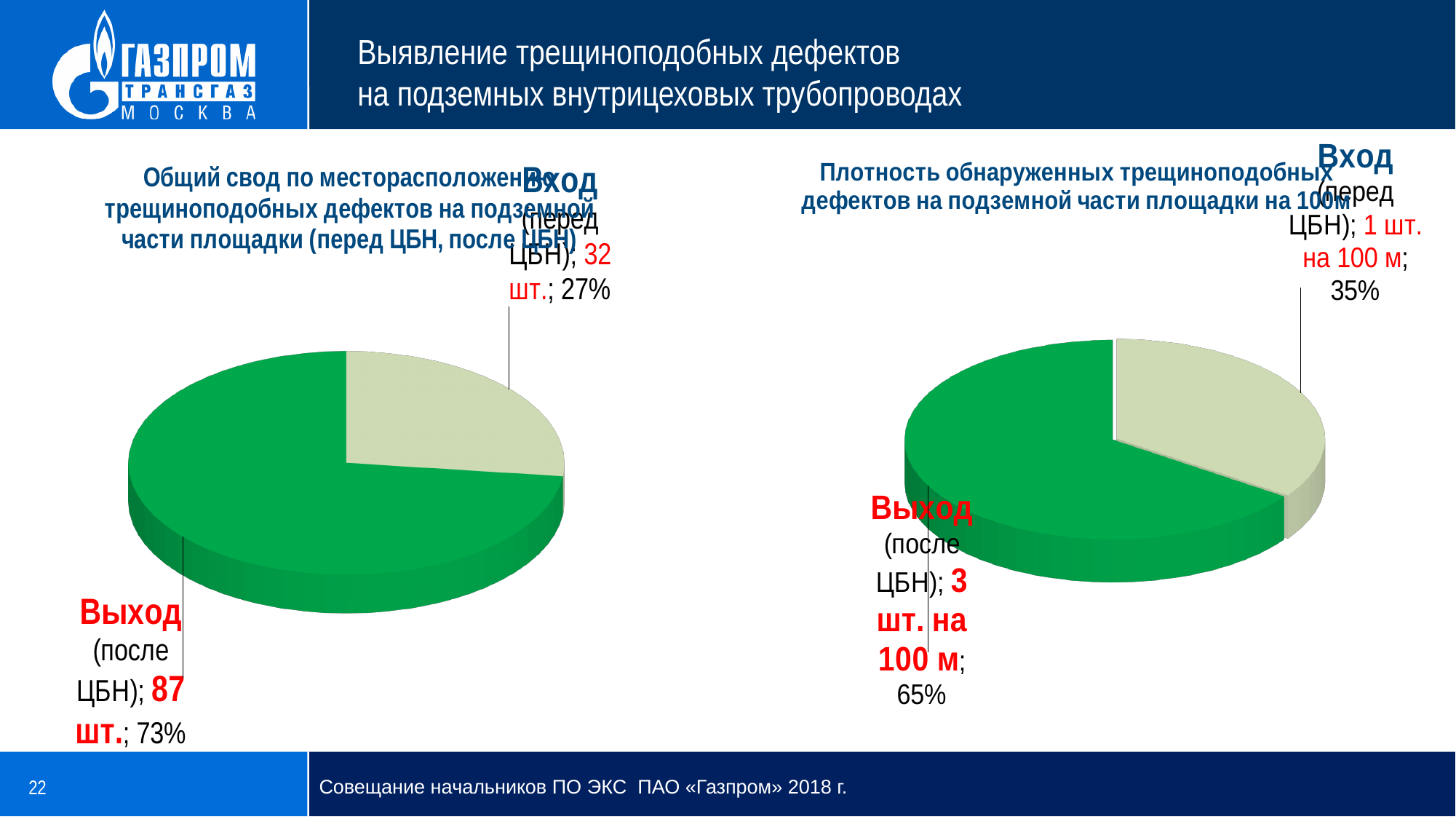
In the left pie chart, which slice is the largest? Выход (после ЦБН) In the left pie chart, what is the difference in the number of defects between Выход (после ЦБН) and Вход (перед ЦБН)? 55 шт. In the right pie chart, what is the defect density for Вход (перед ЦБН)? 1 шт. на 100 м In the left pie chart, how many defects are shown for Выход (после ЦБН)? 87 шт. What kind of chart is the left chart on the slide? pie chart In the left pie chart, what share of the pie does Вход (перед ЦБН) take? 27% In the right pie chart, what share of the pie does Выход (после ЦБН) take? 65% In the right pie chart, what is the defect density for Выход (после ЦБН)? 3 шт. на 100 м How many slices does the right pie chart have? 2 In the left pie chart, how many defects are shown for Вход (перед ЦБН)? 32 шт. In the left pie chart, what is the total number of defects across both slices? 119 шт. In the left pie chart, what share of the pie does Выход (после ЦБН) take? 73%